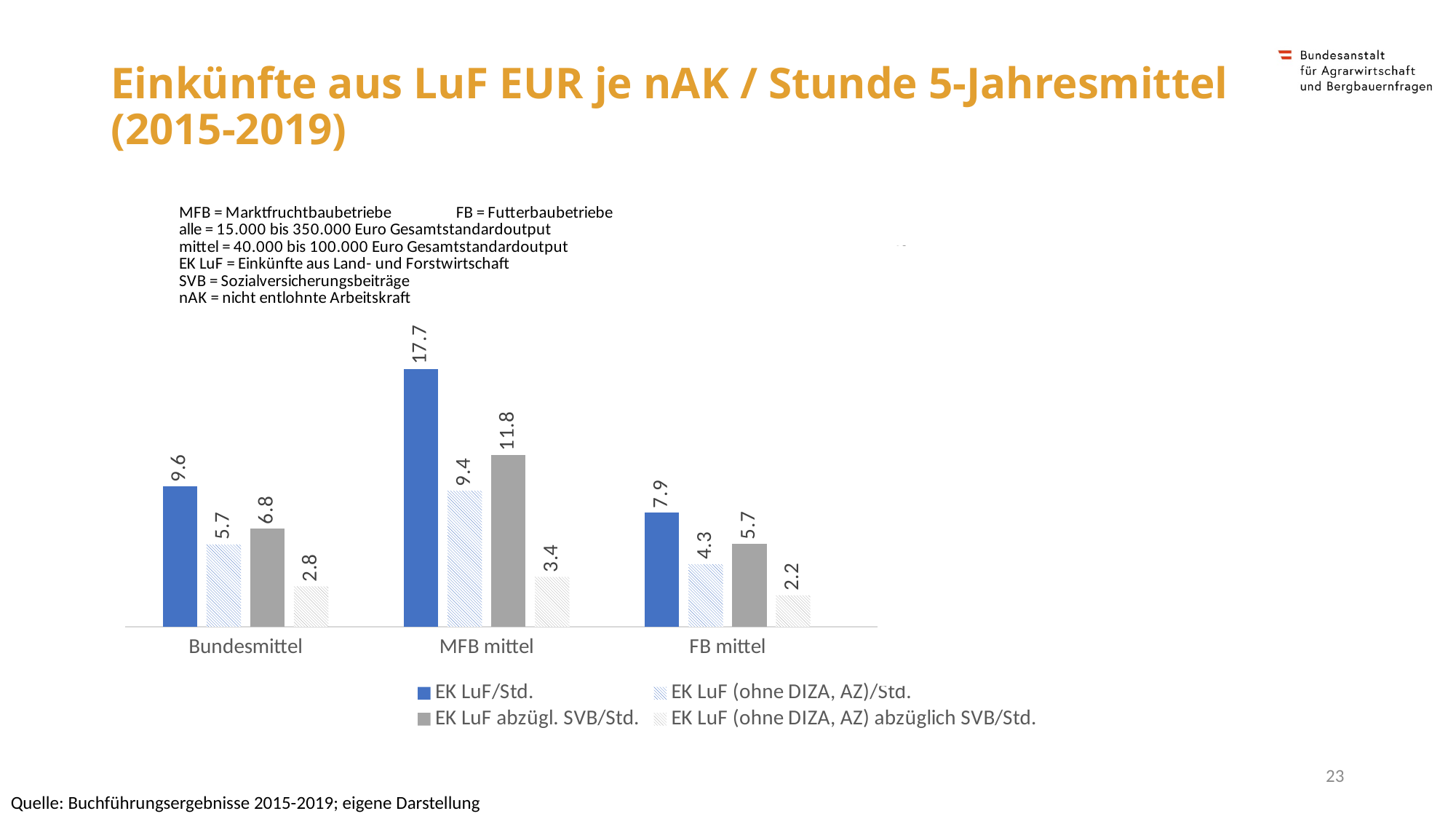
How many categories are shown on the x axis? 3 What kind of chart is shown on the slide? bar chart Which is larger: EK LuF abzügl. SVB/Std. for Bundesmittel or EK LuF (ohne DIZA, AZ)/Std. for MFB mittel? EK LuF (ohne DIZA, AZ)/Std. for MFB mittel What is the value of EK LuF abzügl. SVB/Std. for FB mittel? 5.7 What is the difference between EK LuF/Std. and EK LuF abzügl. SVB/Std. for Bundesmittel? 2.8 Which series is shown in solid blue in the legend? EK LuF/Std. How many series does the legend list? 4 Which category has the lowest value for EK LuF (ohne DIZA, AZ)/Std.? FB mittel What is the difference between EK LuF/Std. for MFB mittel and for FB mittel? 9.8 What is the value of EK LuF (ohne DIZA, AZ) abzüglich SVB/Std. for Bundesmittel? 2.8 What is the value of EK LuF/Std. for MFB mittel? 17.7 Which category has the highest value for EK LuF/Std.? MFB mittel